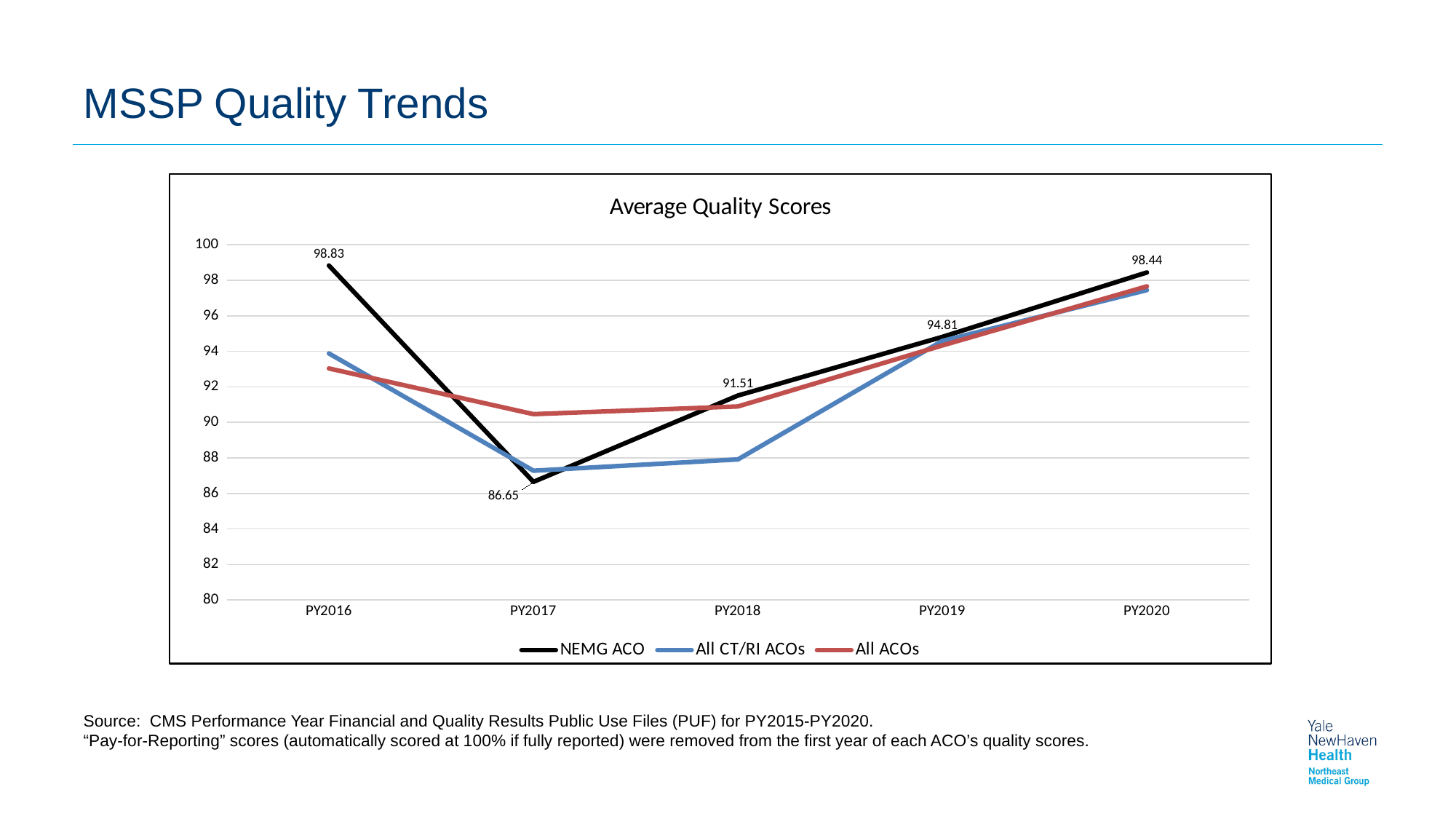
In which performance year is the NEMG ACO score lowest? PY2017 Is the All ACOs value for PY2017 greater or less than 92? less Is the All CT/RI ACOs value for PY2018 greater or less than 90? less What is the NEMG ACO average quality score for PY2016? 98.83 What kind of chart is shown on the slide? line chart How many series does the legend list? 3 What is the NEMG ACO average quality score for PY2020? 98.44 In which performance year is the NEMG ACO score highest? PY2016 What is the difference between the NEMG ACO scores for PY2016 and PY2017? 12.18 What is the NEMG ACO average quality score for PY2017? 86.65 How many performance years are shown on the x axis? 5 Which is larger for NEMG ACO: the PY2018 score or the PY2019 score? PY2019